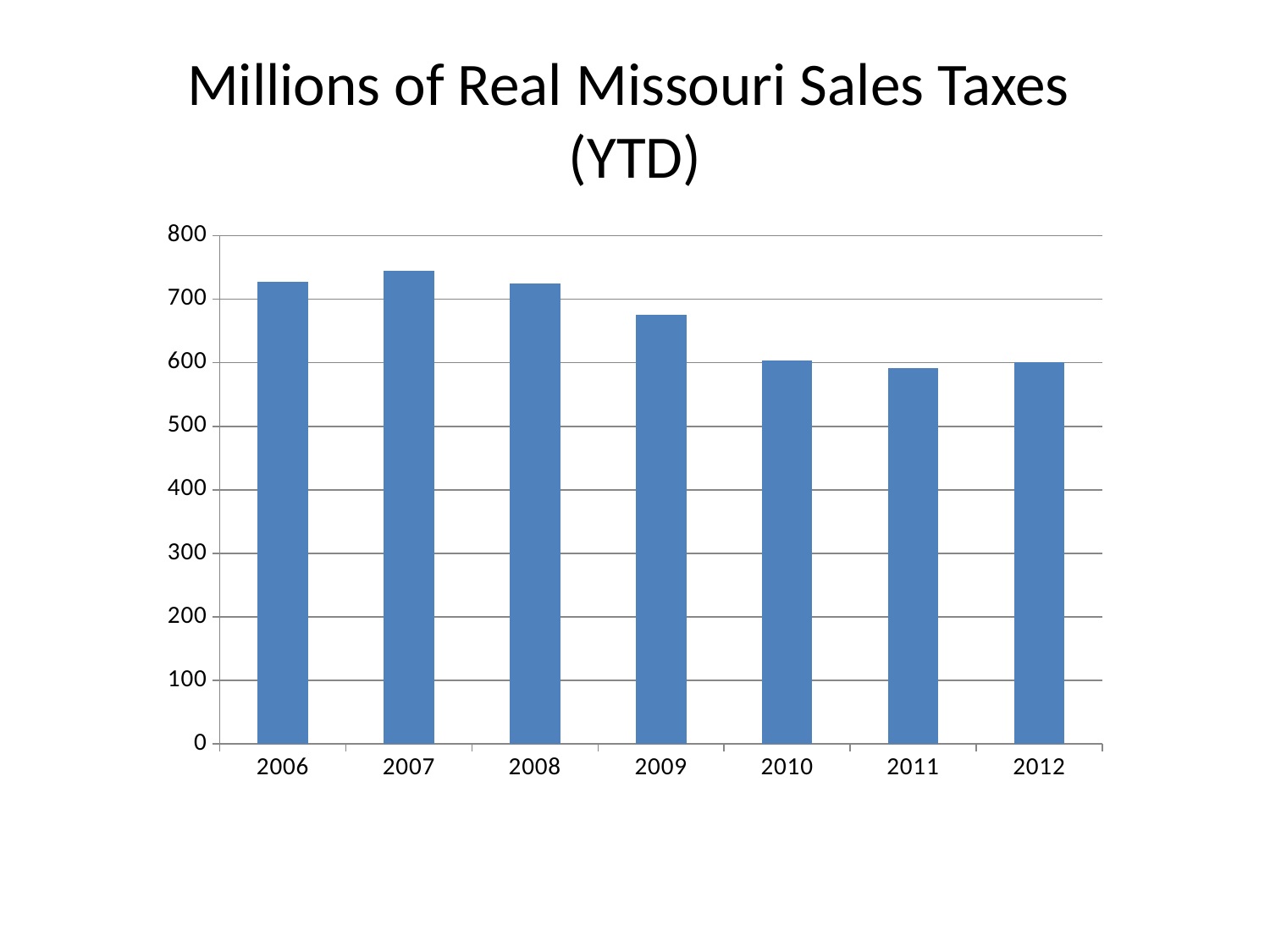
Do the values generally rise or fall from 2006 to 2012? fall Which is larger, the value for 2006 or the value for 2009? 2006 Is the value for 2009 greater or less than 600? greater Which is larger, the value for 2008 or the value for 2011? 2008 Is the value for 2006 greater or less than 700? greater How many years are shown on the x axis of the chart? 7 Is the value for 2009 greater or less than 700? less What kind of chart is shown on the slide? bar chart Which year has the highest bar? 2007 What is the title of the chart? Millions of Real Missouri Sales Taxes (YTD) Which year has the lowest bar? 2011